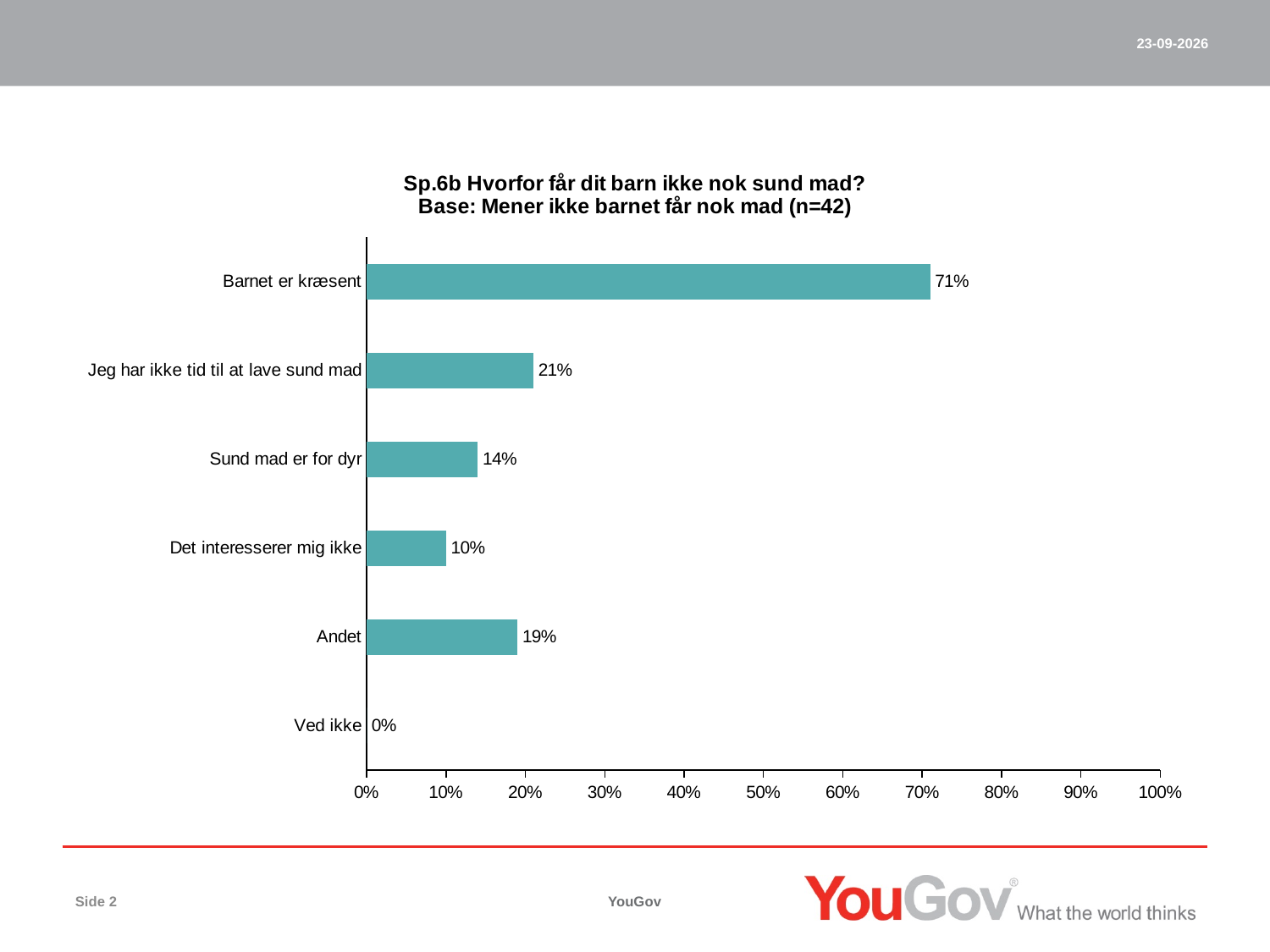
What kind of chart is shown on the slide? Bar chart Which category has the lowest value? Ved ikke What is the value for "Andet"? 19% What is the value for "Sund mad er for dyr"? 14% What is the value for "Ved ikke"? 0% What is the difference between the values for "Barnet er kræsent" and "Jeg har ikke tid til at lave sund mad"? 50% What is the value for "Jeg har ikke tid til at lave sund mad"? 21% What is the base size (n) stated in the chart title? n=42 Which category has the highest value? Barnet er kræsent What is the value for "Barnet er kræsent"? 71% How many categories are shown in the chart? 6 Which is larger, the value for "Andet" or the value for "Sund mad er for dyr"? Andet